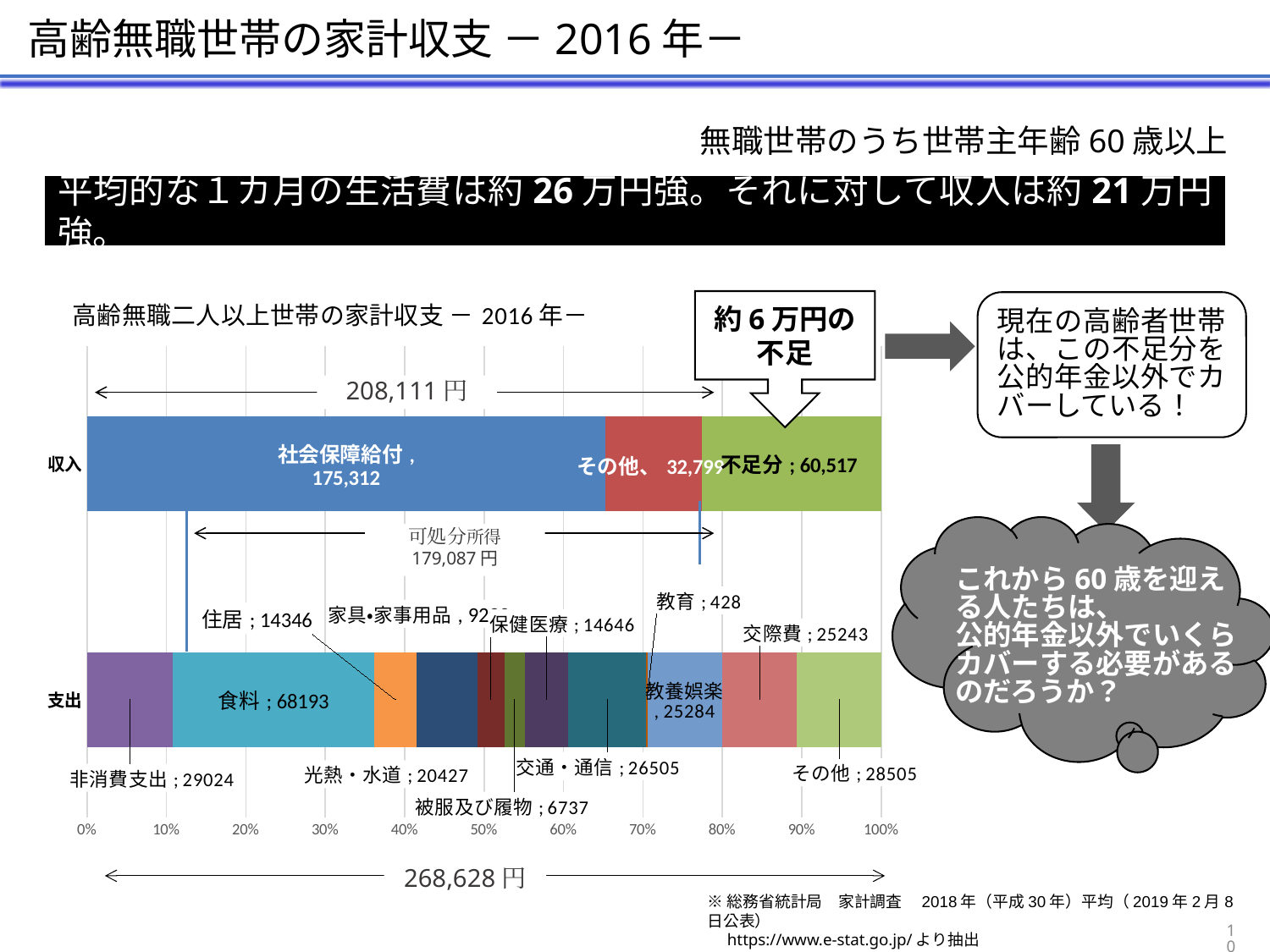
In the chart, what is the value of 非消費支出 in the 支出 bar? 29024 Which segment of the 支出 bar has the smallest value? 教育 What is the difference between 食料 and 非消費支出 in the 支出 bar? 39169 In the chart, what is the value of 食料 in the 支出 bar? 68193 In the chart, what is the value of 社会保障給付 in the 収入 bar? 175,312 In the 支出 bar, which is larger: 食料 or その他? 食料 In the chart, what is the value of 教育 in the 支出 bar? 428 Which segment of the 支出 bar has the largest value? 食料 What is the total of the 支出 bar as printed below the chart? 268,628 円 In the chart, what is the value of 不足分 in the 収入 bar? 60,517 How many segments make up the 収入 bar? 3 What kind of chart is shown on the slide? Stacked bar chart